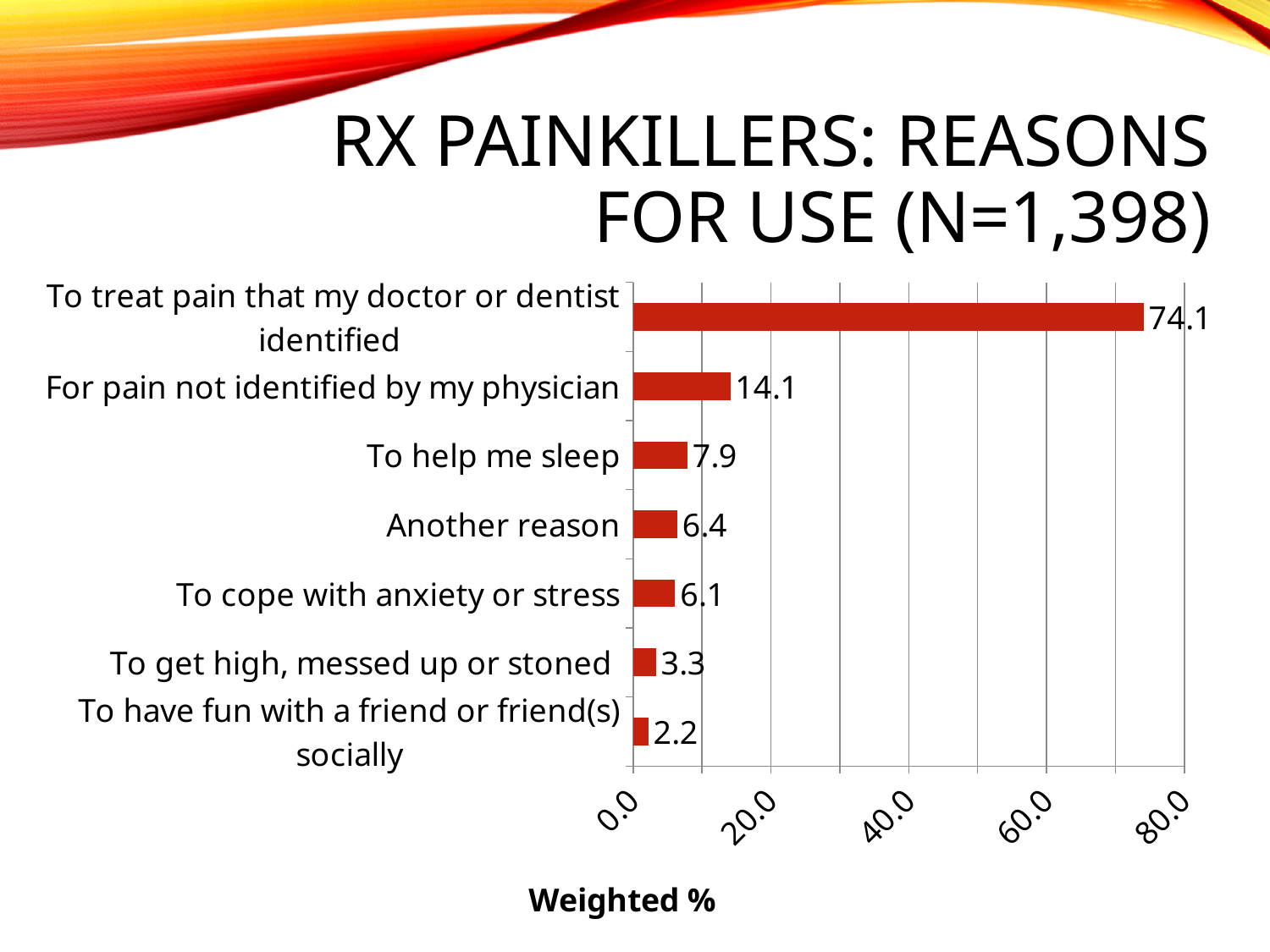
What is the difference in weighted % between "To treat pain that my doctor or dentist identified" and "For pain not identified by my physician"? 60.0 How many reasons are shown in the chart? 7 Which has a higher weighted %, "To help me sleep" or "To cope with anxiety or stress"? To help me sleep What kind of chart is shown on the slide? Bar chart What is the difference in weighted % between "Another reason" and "To cope with anxiety or stress"? 0.3 What is the weighted % for "For pain not identified by my physician"? 14.1 Which reason has the lowest weighted %? To have fun with a friend or friend(s) socially What is the weighted % for "To help me sleep"? 7.9 What is the label on the horizontal axis of the chart? Weighted % What is the weighted % for "To get high, messed up or stoned"? 3.3 Is the value for "To treat pain that my doctor or dentist identified" greater or less than 60.0? greater Which reason has the highest weighted %? To treat pain that my doctor or dentist identified